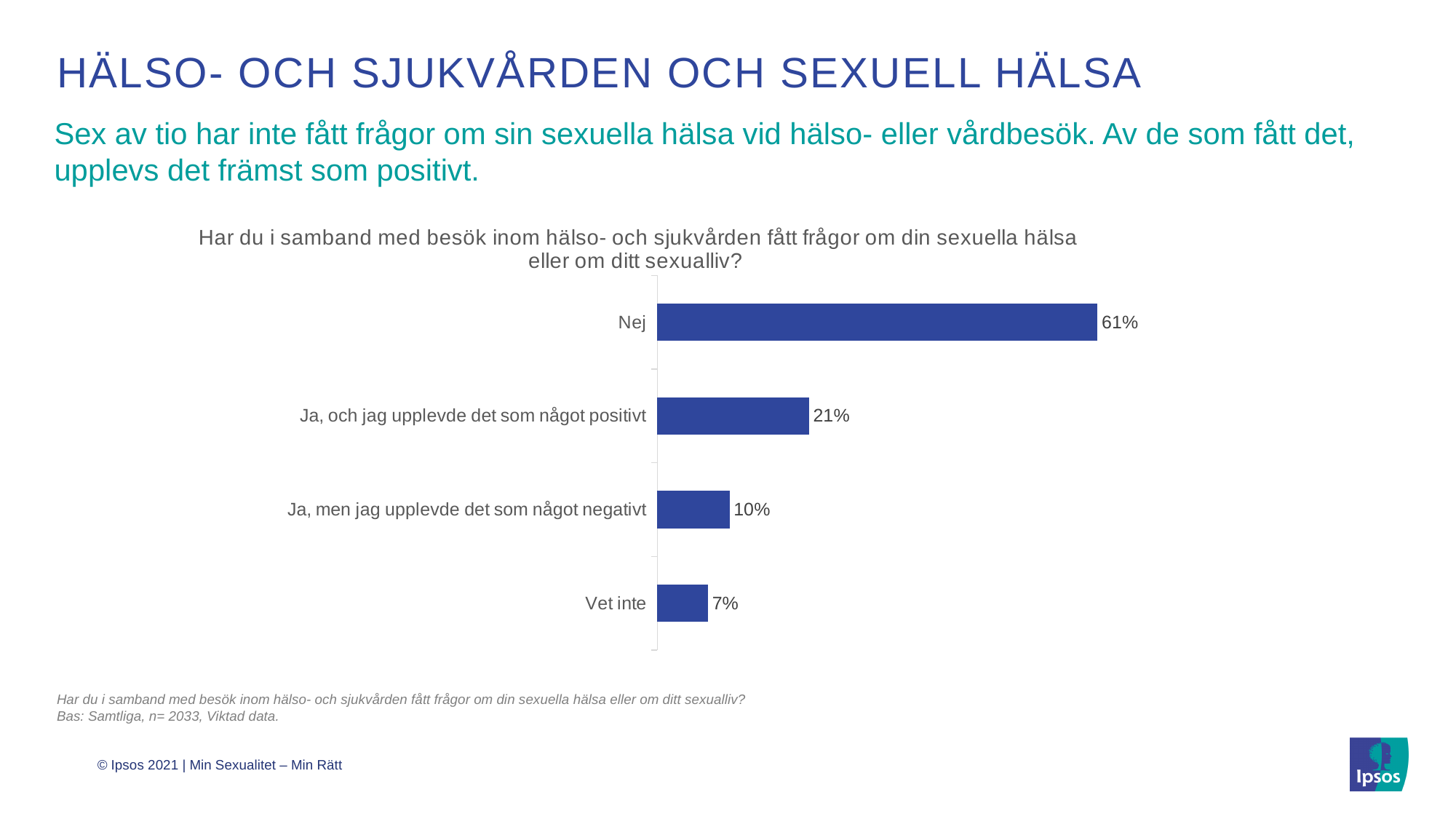
What is the difference between the values for "Ja, men jag upplevde det som något negativt" and "Vet inte"? 3% What is the value for "Ja, och jag upplevde det som något positivt"? 21% What is the difference between the values for "Nej" and "Ja, och jag upplevde det som något positivt"? 40% What is the title of the chart? Har du i samband med besök inom hälso- och sjukvården fått frågor om din sexuella hälsa eller om ditt sexualliv? Which is larger: the value for "Ja, och jag upplevde det som något positivt" or for "Ja, men jag upplevde det som något negativt"? Ja, och jag upplevde det som något positivt Which category has the highest value? Nej What kind of chart is shown on the slide? Bar chart What is the value for "Nej"? 61% How many categories are shown in the chart? 4 What is the value for "Vet inte"? 7% Which category has the lowest value? Vet inte What is the value for "Ja, men jag upplevde det som något negativt"? 10%